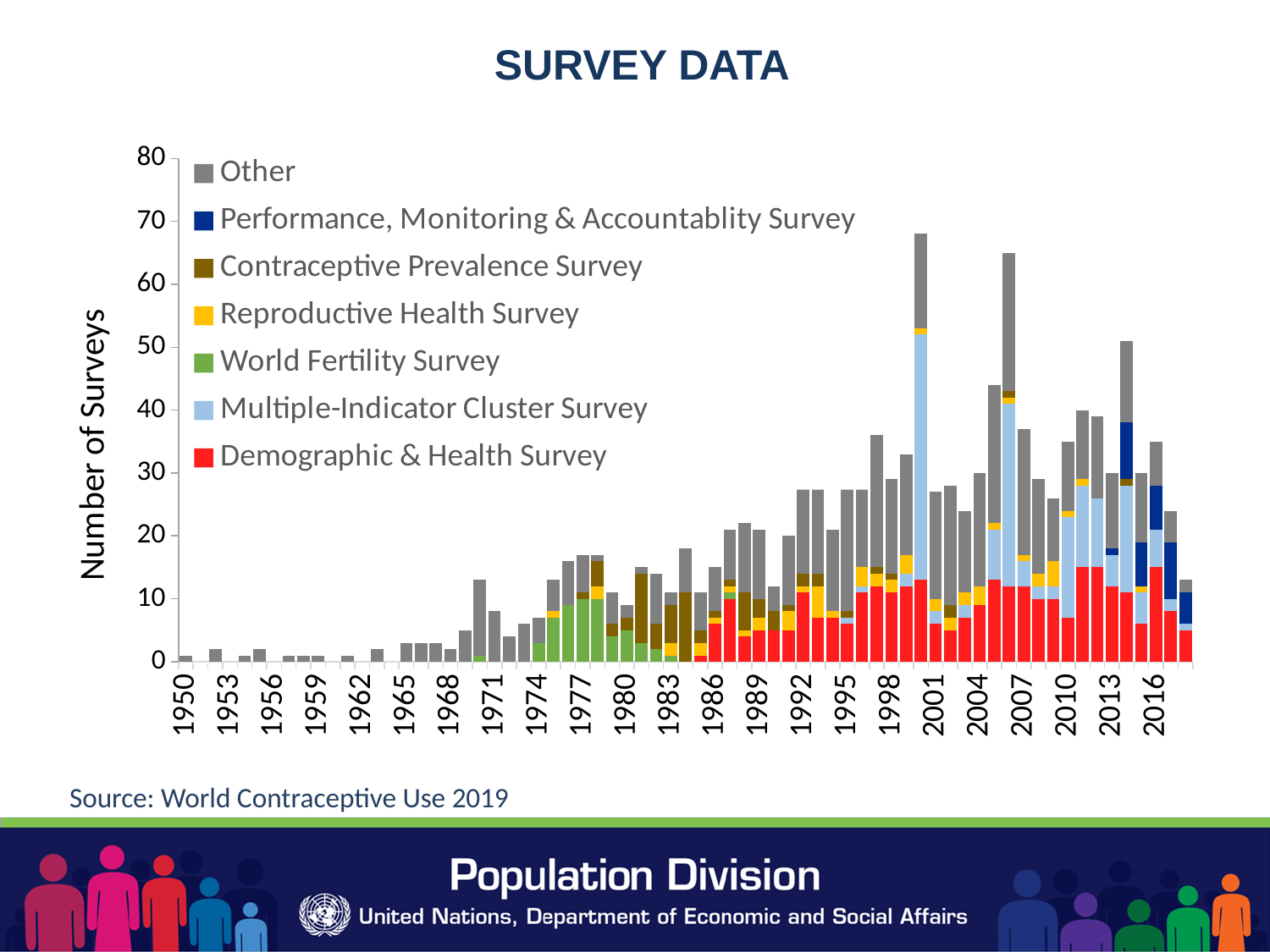
What is the label on the vertical axis? Number of Surveys Is the total number of surveys for 1992 greater or less than 20? greater What kind of chart is shown on the slide? Stacked bar chart How many series does the legend list? 7 Is the total number of surveys for 2000 greater or less than 60? greater Is the total number of surveys for 1950 greater or less than 10? less Overall, does the number of surveys rise or fall from 1950 to 2000? rise Which series is shown in green in the legend? World Fertility Survey Which year has a taller bar, 2000 or 1980? 2000 What is the highest value shown on the vertical axis? 80